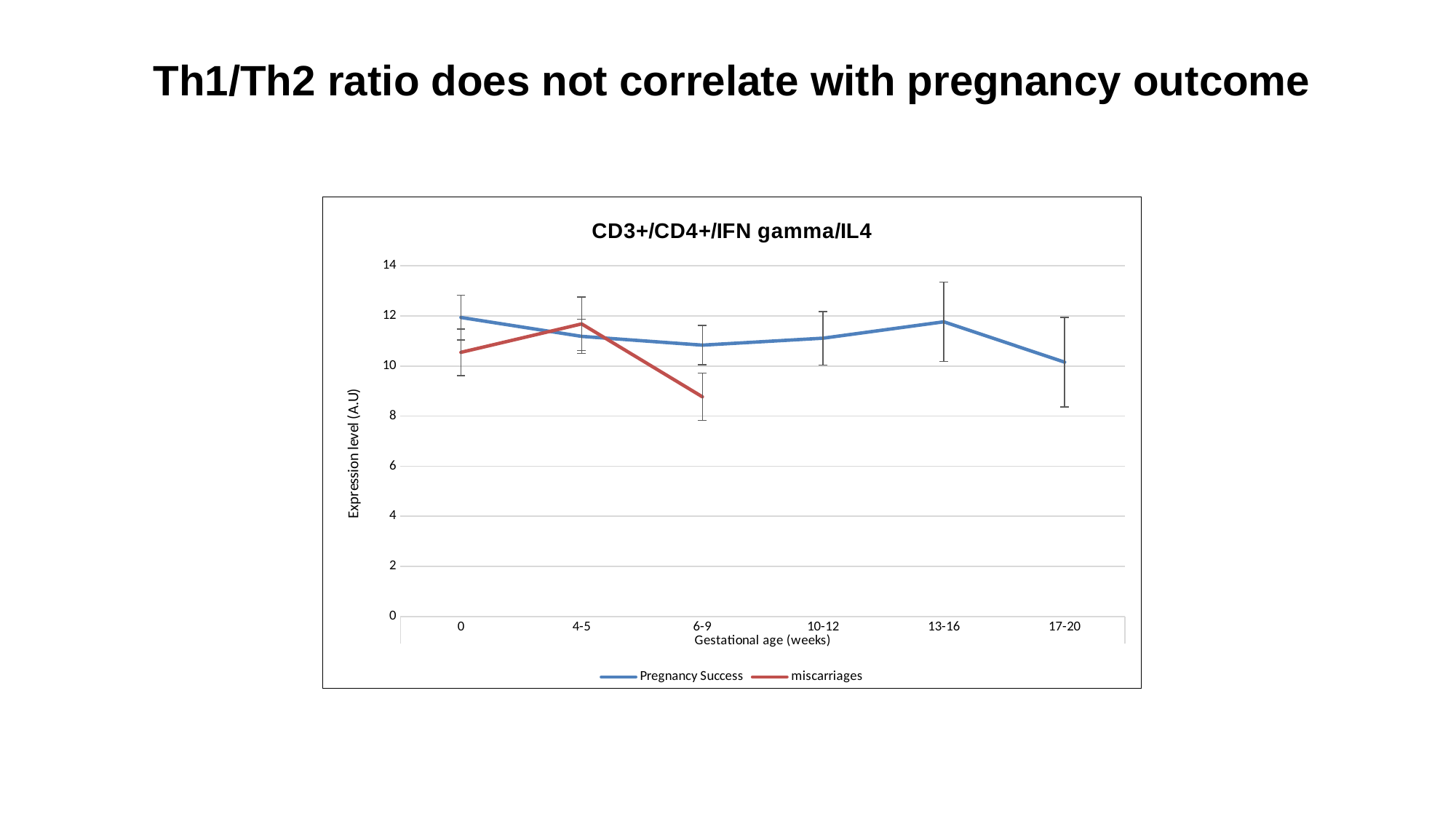
How many series does the legend list? 2 What kind of chart is shown on the slide? Line chart At 6-9 weeks, which series has the larger value, Pregnancy Success or miscarriages? Pregnancy Success Is the value for Pregnancy Success at 0 weeks greater or less than 10? greater Does the miscarriages series rise or fall from 4-5 weeks to 6-9 weeks? Fall At which gestational age is the miscarriages series highest? 4-5 What is the title of the chart? CD3+/CD4+/IFN gamma/IL4 At which gestational age is the miscarriages series lowest? 6-9 How many gestational age categories are shown on the x axis? 6 Is the value for miscarriages at 6-9 weeks greater or less than 10? less How many data points are plotted for the miscarriages series? 3 What is the label of the y axis? Expression level (A.U)